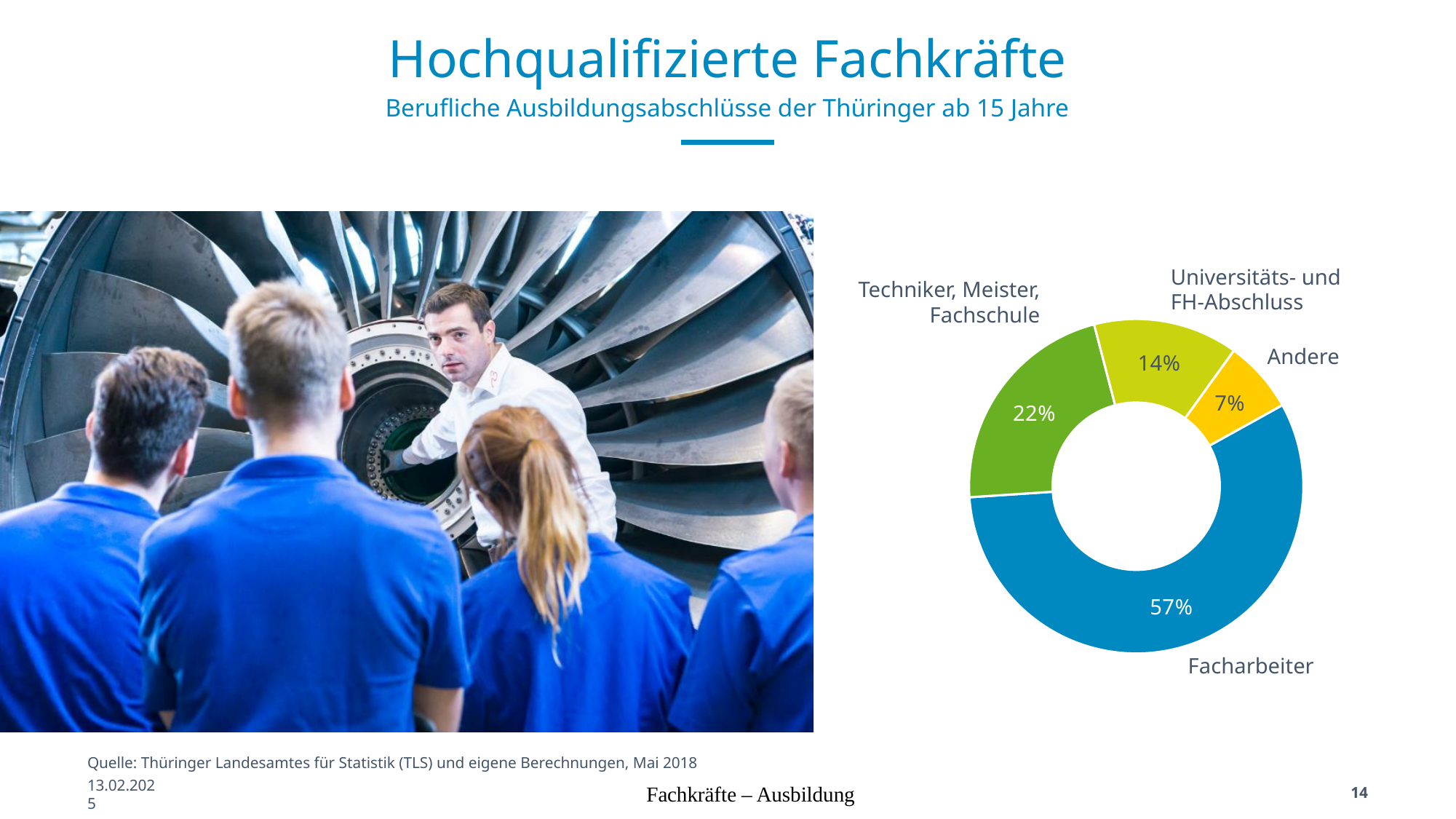
Which is larger: Universitäts- und FH-Abschluss or Andere? Universitäts- und FH-Abschluss What is the difference between the shares of Facharbeiter and Techniker, Meister, Fachschule? 35 percentage points Which category has the smallest share? Andere How many categories are shown in the chart? 4 What colour is the Facharbeiter segment? Blue What share of the chart does Facharbeiter represent? 57% Which category has the largest share? Facharbeiter What is the combined share of Techniker, Meister, Fachschule and Universitäts- und FH-Abschluss? 36% What kind of chart is shown on the slide? Doughnut (pie) chart What is the value for Universitäts- und FH-Abschluss? 14% What is the value for Andere? 7% What is the value for Techniker, Meister, Fachschule? 22%